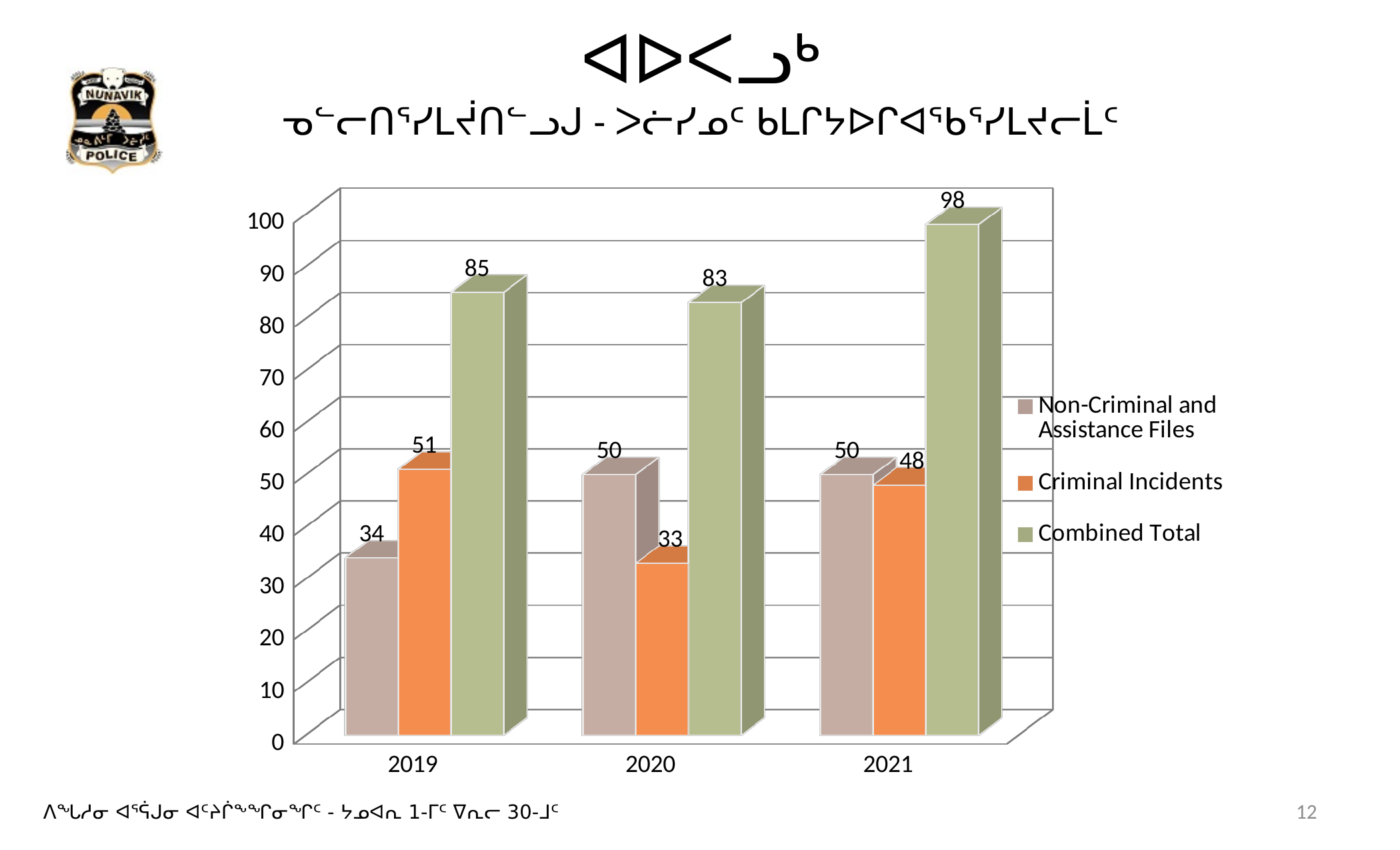
Which year has the lowest value for Criminal Incidents? 2020 Which year has the highest Combined Total? 2021 What is the difference between the Combined Total in 2021 and in 2019? 13 How many years are shown on the x axis? 3 What is the Combined Total for 2021? 98 How many series does the legend list? 3 Which colour represents Criminal Incidents in the legend? orange Is the Combined Total for 2020 greater or less than 80? greater Which is larger in 2019: Non-Criminal and Assistance Files or Criminal Incidents? Criminal Incidents What is the value for Non-Criminal and Assistance Files in 2020? 50 What is the value for Criminal Incidents in 2019? 51 What kind of chart is shown on the slide? bar chart